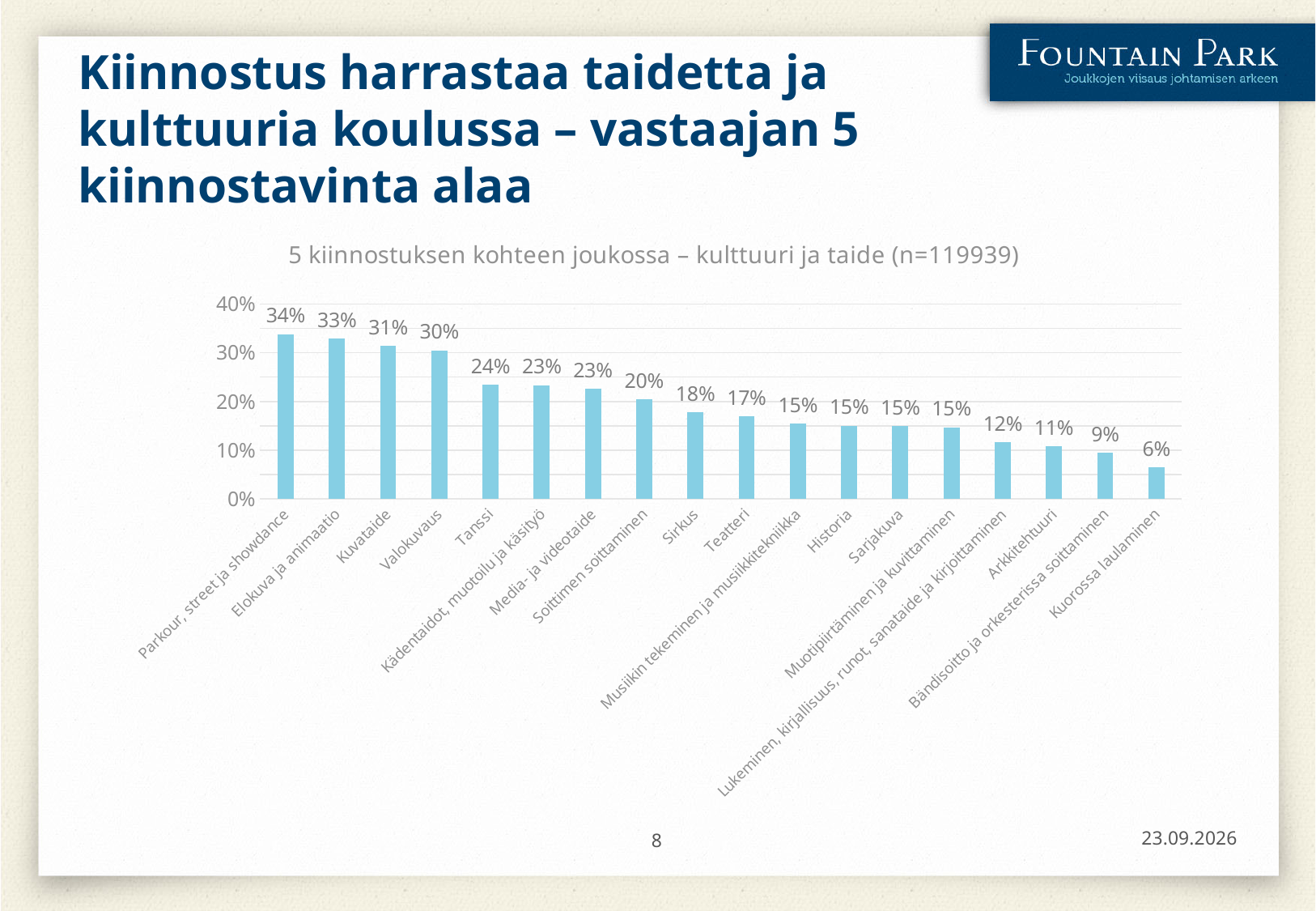
What is the sample size (n) given in the chart title? 119939 Which category has the lowest value? Kuorossa laulaminen What is the value for Kuvataide? 31% Do the values rise or fall from left to right along the x axis? fall How many categories are shown in the chart? 18 Which category has the highest value? Parkour, street ja showdance Is the value for Elokuva ja animaatio greater or less than 30%? greater Which is larger, the value for Teatteri or the value for Soittimen soittaminen? Soittimen soittaminen What is the value for Arkkitehtuuri? 11% What is the value for Sirkus? 18% What kind of chart is shown on the slide? bar chart What is the difference between the values for Valokuvaus and Tanssi? 6%